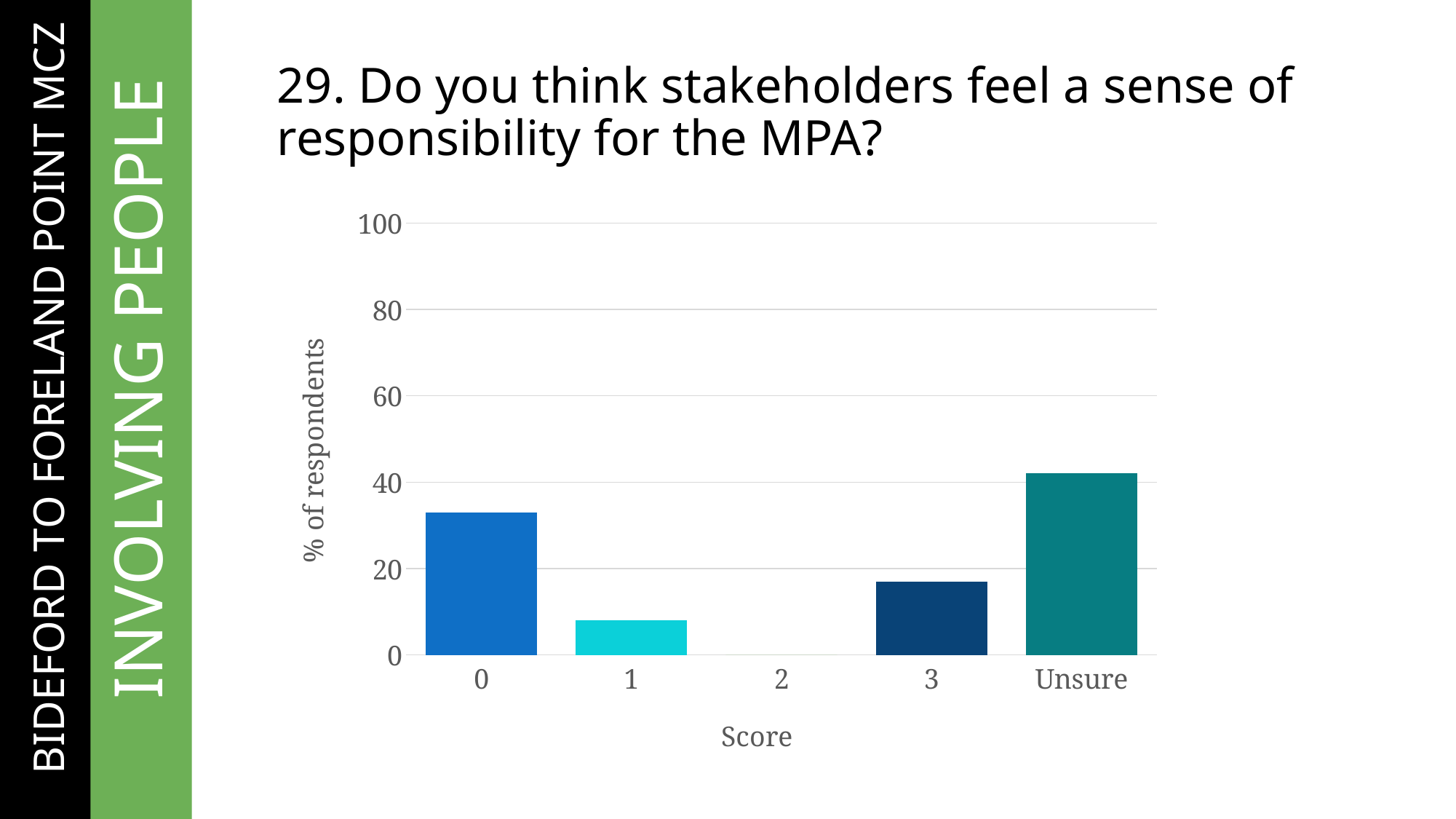
Which has a higher percentage of respondents, score 0 or score 3? 0 Is the value for Unsure greater or less than 20? greater How many score categories are shown on the x axis of the chart? 5 Is the value for score 0 greater or less than 40? less What is the label on the y axis of the chart? % of respondents Which has a higher percentage of respondents, score 1 or score 3? 3 What kind of chart is shown on the slide? bar chart Which score category has the lowest percentage of respondents? 2 Which score category has the highest percentage of respondents? Unsure What is the percentage of respondents for score 2? 0 Is the value for score 1 greater or less than 20? less